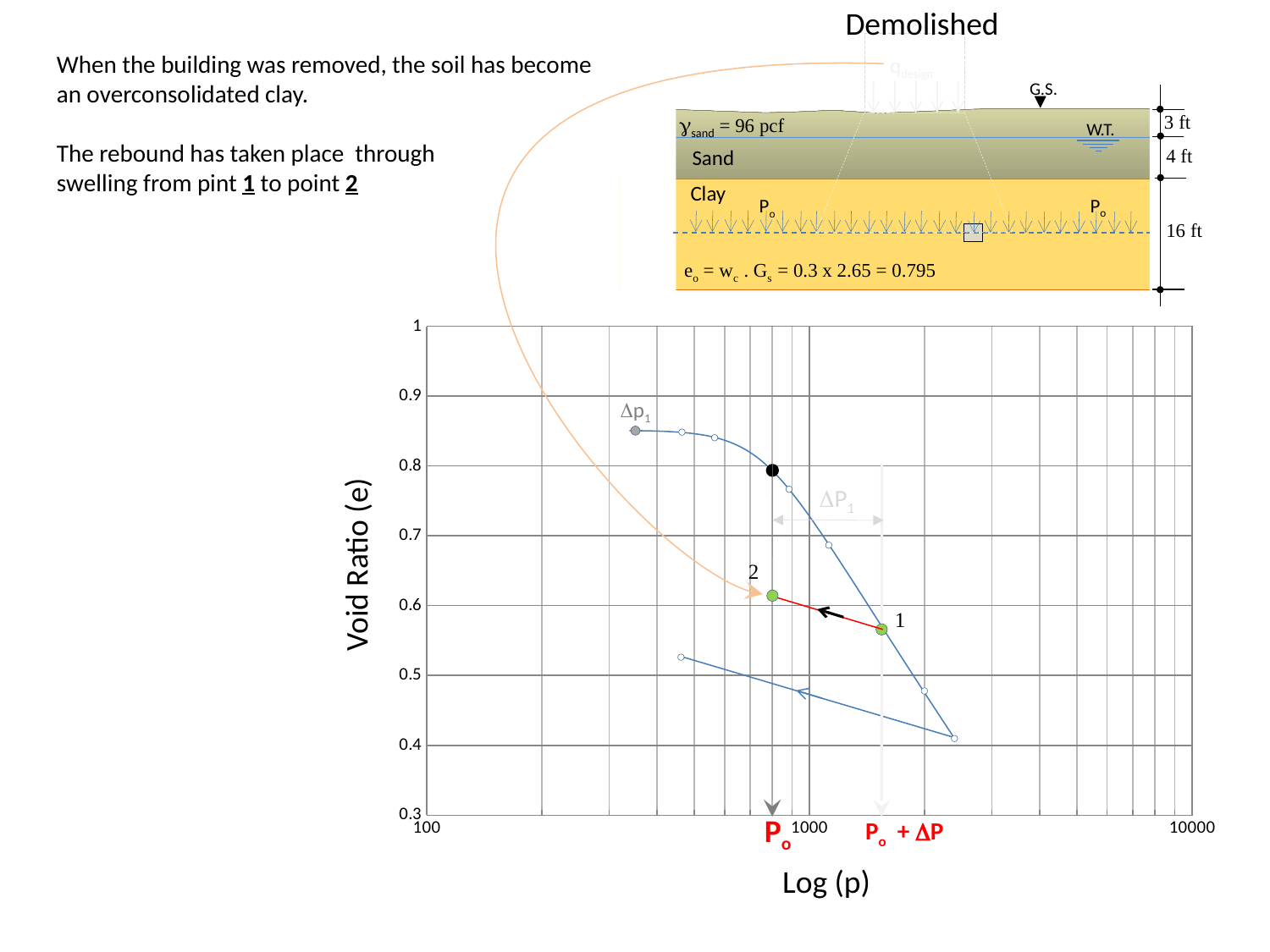
Is the void ratio at the point labelled Δp1 greater or less than 0.9? less Along the main curve, does the void ratio rise or fall as p increases? fall Is the void ratio at point 2 greater or less than 0.7? less What kind of chart is shown on the slide? line chart What is the title of the vertical axis of the chart? Void Ratio (e) Is the void ratio at the point labelled Δp1 greater or less than 0.8? greater What is the highest value shown on the vertical axis? 1 What is the title of the horizontal axis of the chart? Log (p) Which has the higher void ratio, point 1 or point 2? point 2